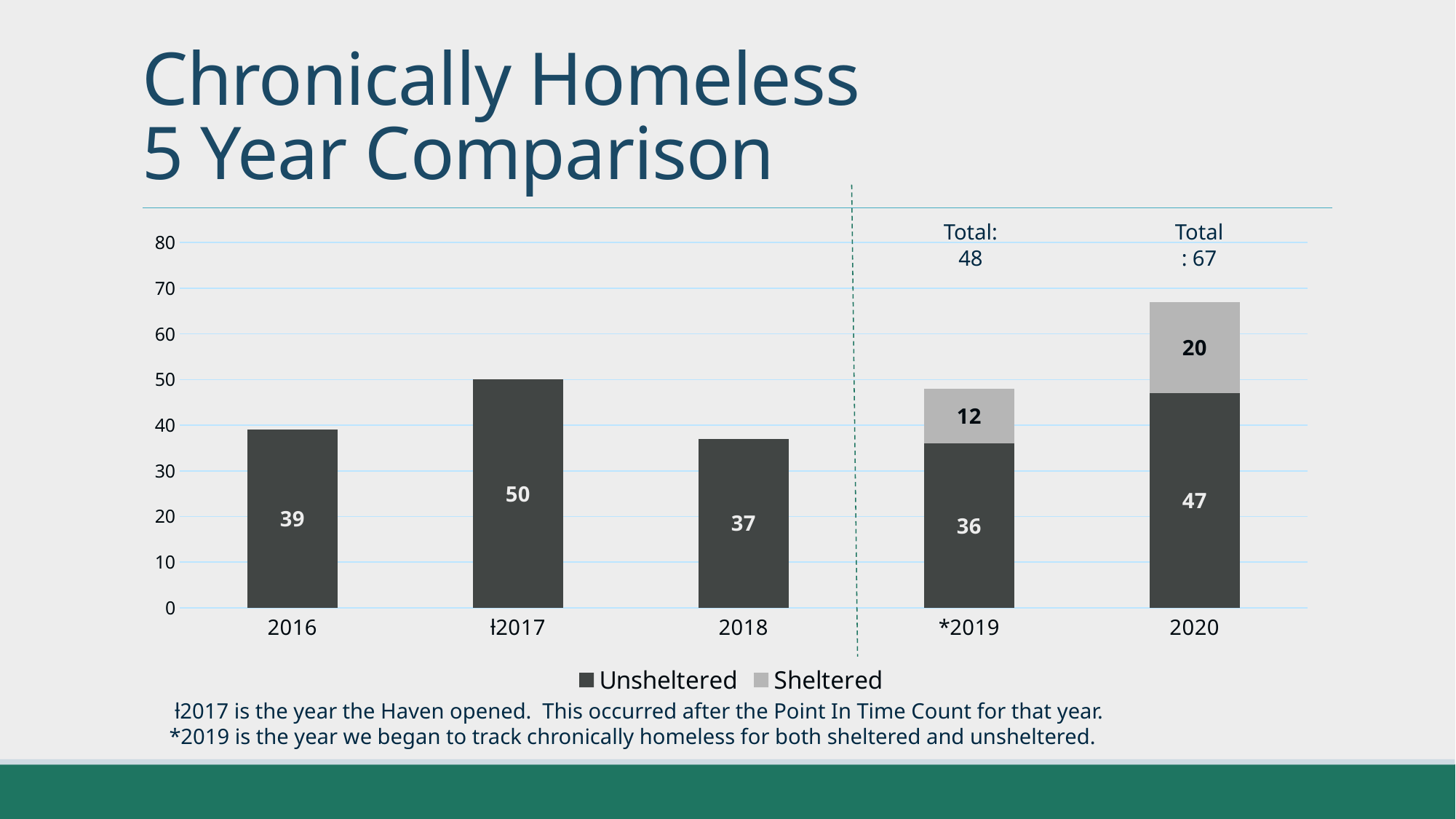
What is the difference between the Unsheltered values for ł2017 and 2018? 13 Which year has the lowest Unsheltered value? *2019 Is the Unsheltered value for 2020 larger than the Unsheltered value for 2016? Yes What is the Unsheltered value for 2016? 39 What is the Unsheltered value for *2019? 36 What is the total of the stacked bar for *2019? 48 What is the Sheltered value for 2020? 20 How many years are shown on the x axis? 5 How many series does the legend list? 2 What is the total of the stacked bar for 2020? 67 What kind of chart is shown on the slide? Bar chart Which year has the highest Unsheltered value? ł2017